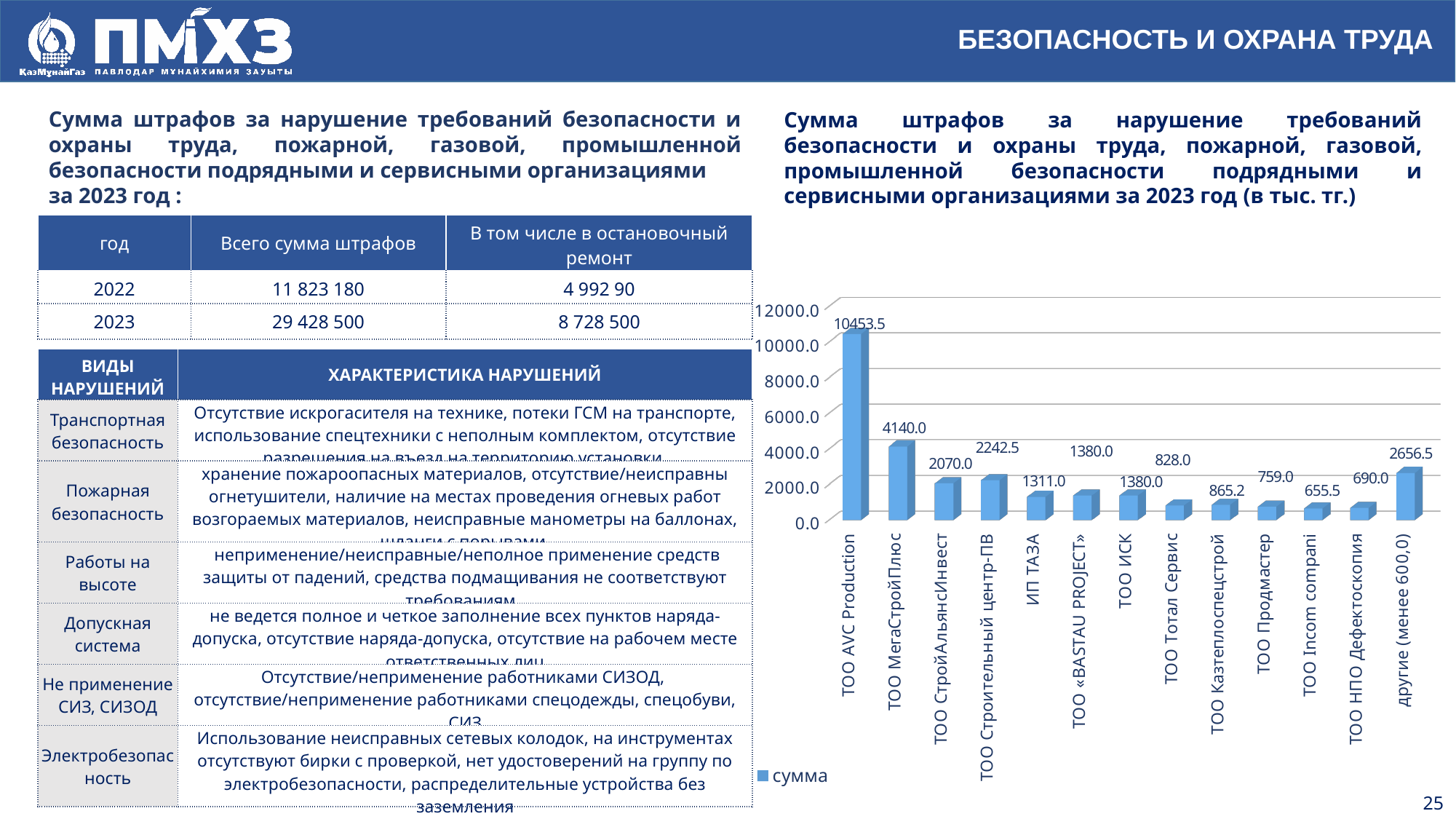
What is the value for ТОО Казтеплоспецстрой in the bar chart? 865.2 What is the value for другие (менее 600,0) in the bar chart? 2656.5 What is the value for ТОО AVC Production in the bar chart? 10453.5 Which category has the highest value in the bar chart? ТОО AVC Production What is the difference between the values for ТОО AVC Production and ТОО МегаСтройПлюс? 6313.5 Which is larger in the bar chart: the value for ТОО Строительный центр-ПВ or ТОО СтройАльянсИнвест? ТОО Строительный центр-ПВ What is the difference between the values for ТОО Строительный центр-ПВ and ТОО СтройАльянсИнвест? 172.5 What series name does the legend of the bar chart list? сумма Which category has the lowest value in the bar chart? ТОО Incom compani How many categories are shown on the x axis of the bar chart? 13 What is the value for ТОО МегаСтройПлюс in the bar chart? 4140.0 Is the value for ТОО AVC Production greater or less than 10000.0? greater